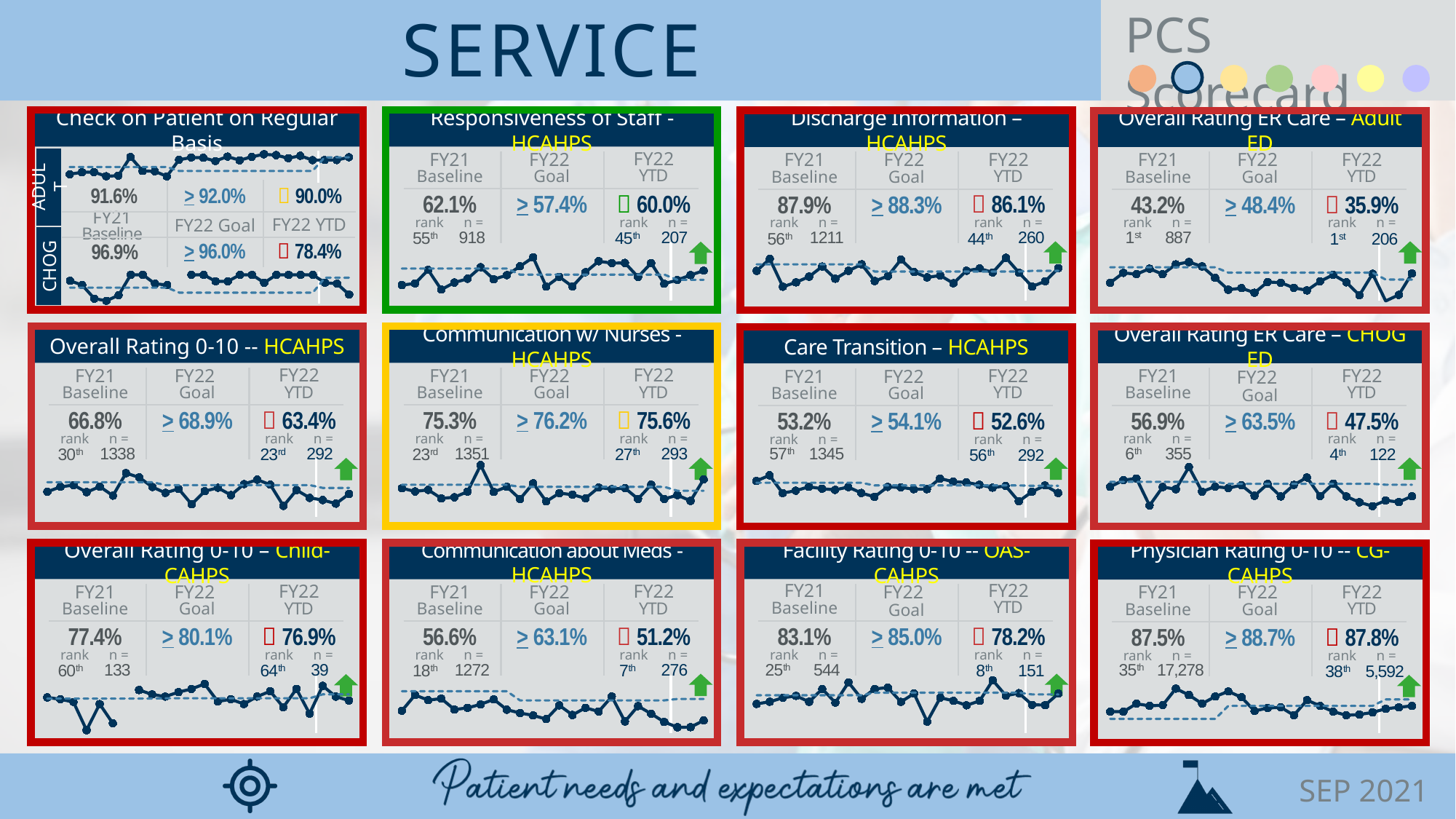
What kind of chart is shown at the bottom of each scorecard panel? Line chart In the Physician Rating 0-10 -- CG-CAHPS panel, which is larger, the FY21 Baseline or the FY22 YTD value? FY22 YTD In the Responsiveness of Staff - HCAHPS panel, what is the FY22 YTD value? 60.0% In the Communication w/ Nurses - HCAHPS panel, what is the FY22 Goal? ≥ 76.2% In the Physician Rating 0-10 -- CG-CAHPS panel, what is the n for the FY21 Baseline? 17,278 How many scorecard panels with charts are on the slide? 12 In the Care Transition – HCAHPS panel, what is the FY22 YTD rank? 56th In the Facility Rating 0-10 -- OAS-CAHPS panel, what is the difference between the FY21 Baseline and the FY22 YTD value? 4.9% In the Overall Rating ER Care – Adult ED panel, what is the FY21 Baseline value? 43.2% In the Overall Rating ER Care – CHOG ED panel, what is the difference between the FY22 Goal and the FY22 YTD value? 16.0% In the Communication about Meds - HCAHPS panel, which is larger, the FY21 Baseline or the FY22 YTD value? FY21 Baseline In the Check on Patient on Regular Basis panel, what is the FY22 YTD value for CHOG? 78.4%